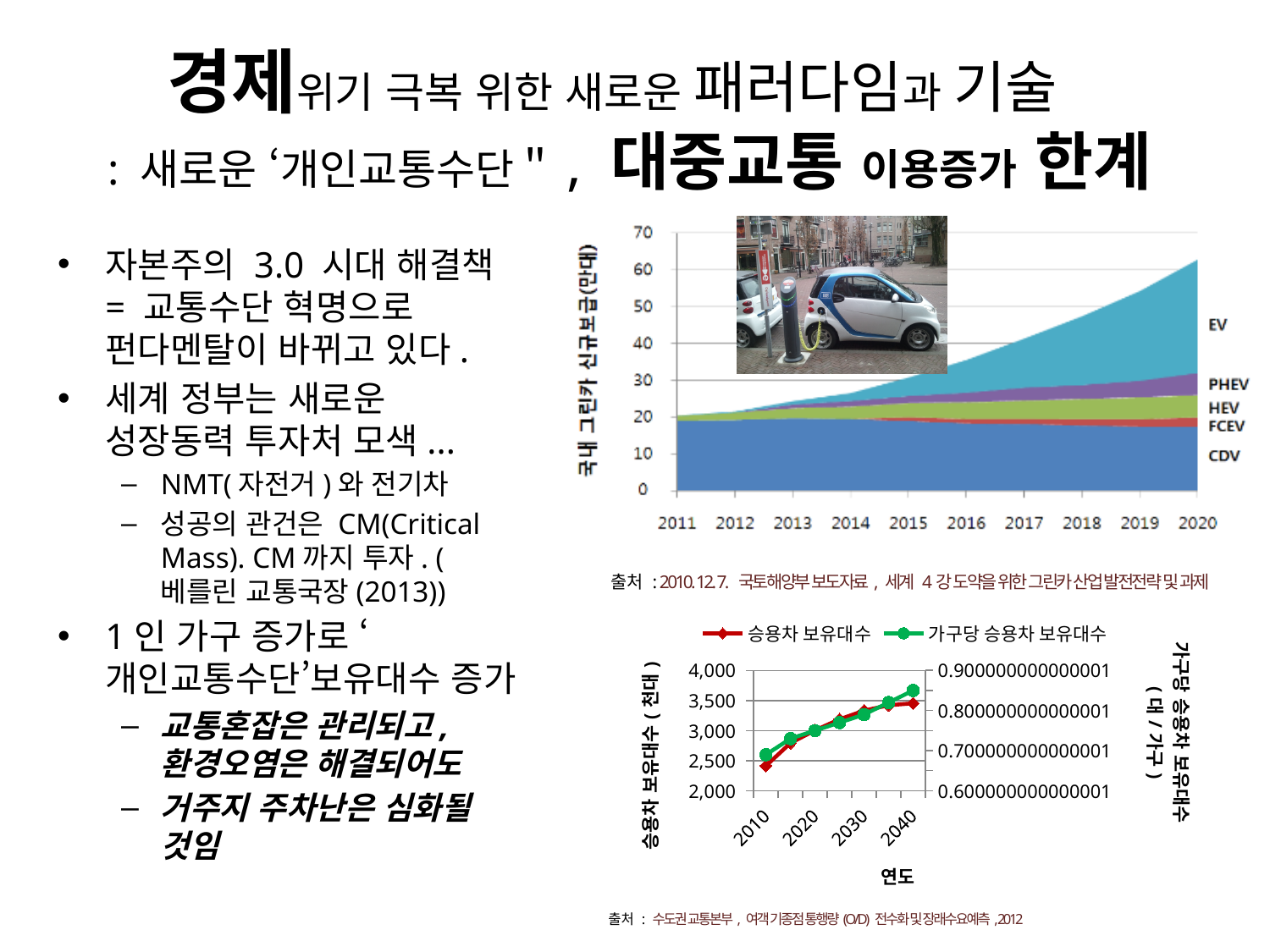
In the top chart (국내 그린카 신규보급), what kind of chart is it? stacked area chart In the bottom chart, does 가구당 승용차 보유대수 rise or fall from 2010 to 2040? rise In the top chart (국내 그린카 신규보급), how many series are labelled on the right side of the plot? 5 In the top chart (국내 그린카 신규보급), which series is plotted at the bottom of the stack? CDV In the top chart (국내 그린카 신규보급), which series has the largest area in 2020? EV In the top chart (국내 그린카 신규보급), is the total new supply in 2020 greater or less than 50? greater In the bottom chart (승용차 보유대수), what kind of chart is it? line chart In the top chart (국내 그린카 신규보급), does the total new supply rise or fall from 2011 to 2020? rise In the bottom chart (승용차 보유대수), how many series does the legend list? 2 In the bottom chart, is the value of 승용차 보유대수 in 2010 greater or less than 3,000? less In the bottom chart, is the value of 승용차 보유대수 in 2040 greater or less than 3,000? greater